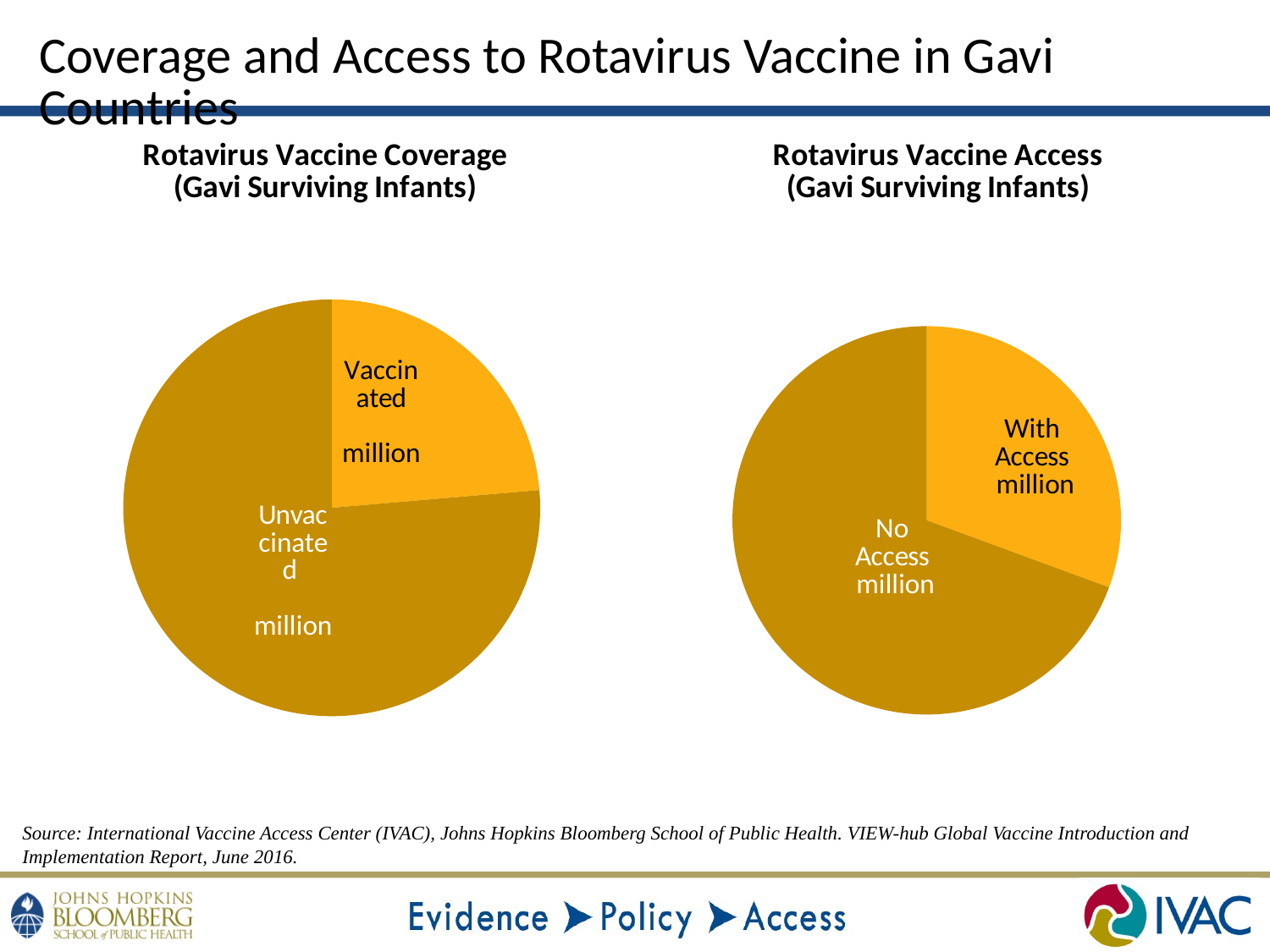
What kind of chart is the Rotavirus Vaccine Access chart on the right? Pie chart In the Rotavirus Vaccine Access chart, which is larger: the With Access slice or the No Access slice? No Access In the Rotavirus Vaccine Access chart, which slice is the largest? No Access What is the title of the pie chart on the left of the slide? Rotavirus Vaccine Coverage (Gavi Surviving Infants) In the Rotavirus Vaccine Coverage chart, which slice is the largest? Unvaccinated How many slices does the Rotavirus Vaccine Coverage pie chart have? 2 How many slices does the Rotavirus Vaccine Access pie chart have? 2 In the Rotavirus Vaccine Access chart, which slice is the smallest? With Access What kind of chart is the Rotavirus Vaccine Coverage chart on the left? Pie chart In the Rotavirus Vaccine Coverage chart, which is larger: the Vaccinated slice or the Unvaccinated slice? Unvaccinated In the Rotavirus Vaccine Coverage chart, which slice is the smallest? Vaccinated What is the title of the pie chart on the right of the slide? Rotavirus Vaccine Access (Gavi Surviving Infants)